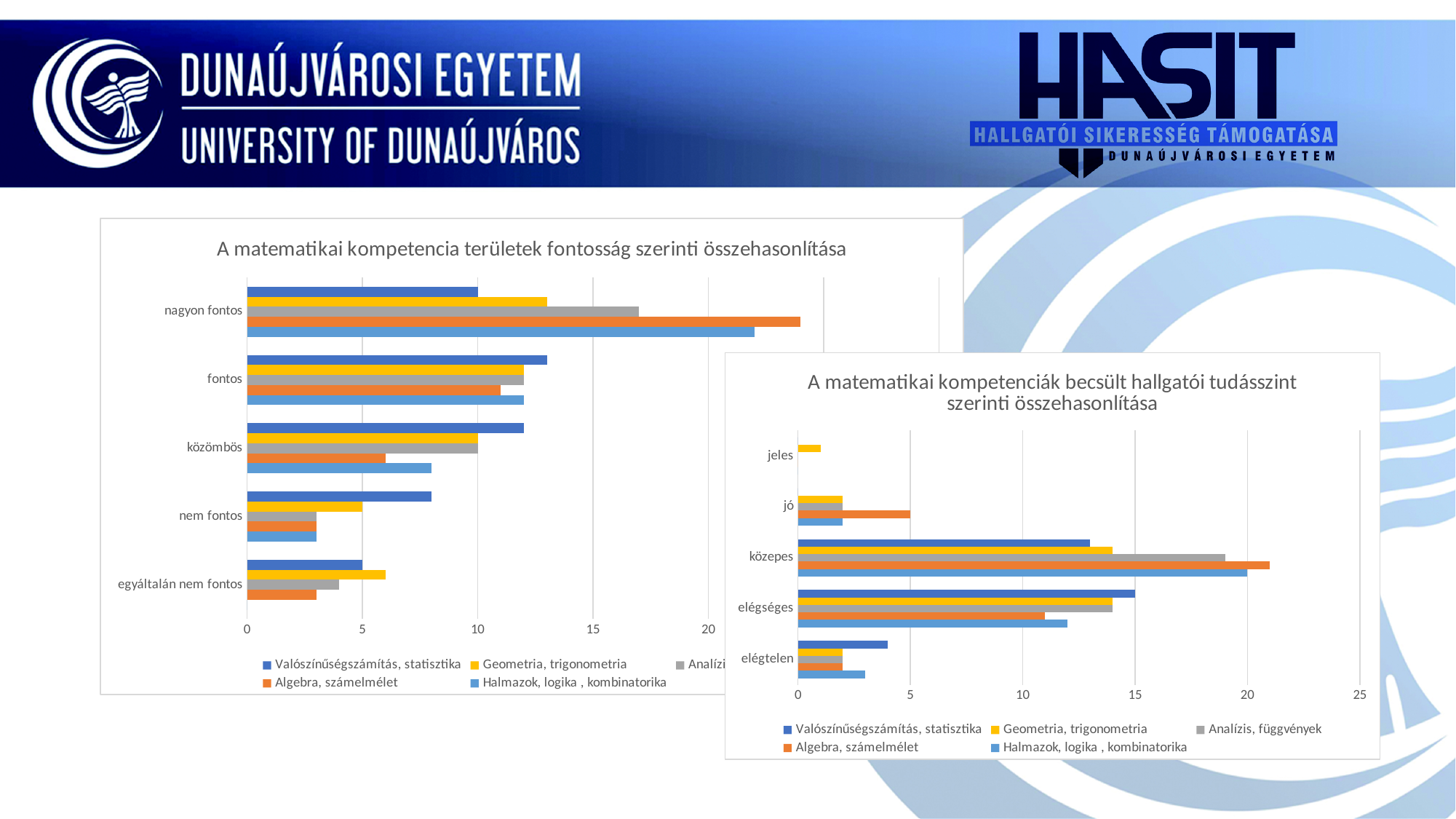
In the chart titled 'A matematikai kompetenciák becsült hallgatói tudásszint szerinti összehasonlítása', which series is the only one with a visible bar for 'jeles'? Geometria, trigonometria How many series does the legend list in the chart titled 'A matematikai kompetenciák becsült hallgatói tudásszint szerinti összehasonlítása'? 5 In the chart titled 'A matematikai kompetenciák becsült hallgatói tudásszint szerinti összehasonlítása', is the value for 'Algebra, számelmélet' at 'közepes' greater or less than 15? greater What type of chart is the chart titled 'A matematikai kompetencia területek fontosság szerinti összehasonlítása'? bar chart In the chart titled 'A matematikai kompetencia területek fontosság szerinti összehasonlítása', is the value for 'Algebra, számelmélet' at 'nagyon fontos' greater or less than 20? greater How many categories are shown on the y axis of the chart titled 'A matematikai kompetenciák becsült hallgatói tudásszint szerinti összehasonlítása'? 5 In the chart titled 'A matematikai kompetencia területek fontosság szerinti összehasonlítása', is the value for 'Valószínűségszámítás, statisztika' at 'nem fontos' greater or less than 10? less In the chart titled 'A matematikai kompetenciák becsült hallgatói tudásszint szerinti összehasonlítása', which is larger for 'elégtelen': 'Valószínűségszámítás, statisztika' or 'Geometria, trigonometria'? Valószínűségszámítás, statisztika In the chart titled 'A matematikai kompetencia területek fontosság szerinti összehasonlítása', which series has the longest bar for 'nagyon fontos'? Algebra, számelmélet In the chart titled 'A matematikai kompetencia területek fontosság szerinti összehasonlítása', which series has the shortest bar for 'nagyon fontos'? Valószínűségszámítás, statisztika How many categories are shown on the y axis of the chart titled 'A matematikai kompetencia területek fontosság szerinti összehasonlítása'? 5 In the chart titled 'A matematikai kompetencia területek fontosság szerinti összehasonlítása', which is larger for 'közömbös': 'Valószínűségszámítás, statisztika' or 'Algebra, számelmélet'? Valószínűségszámítás, statisztika